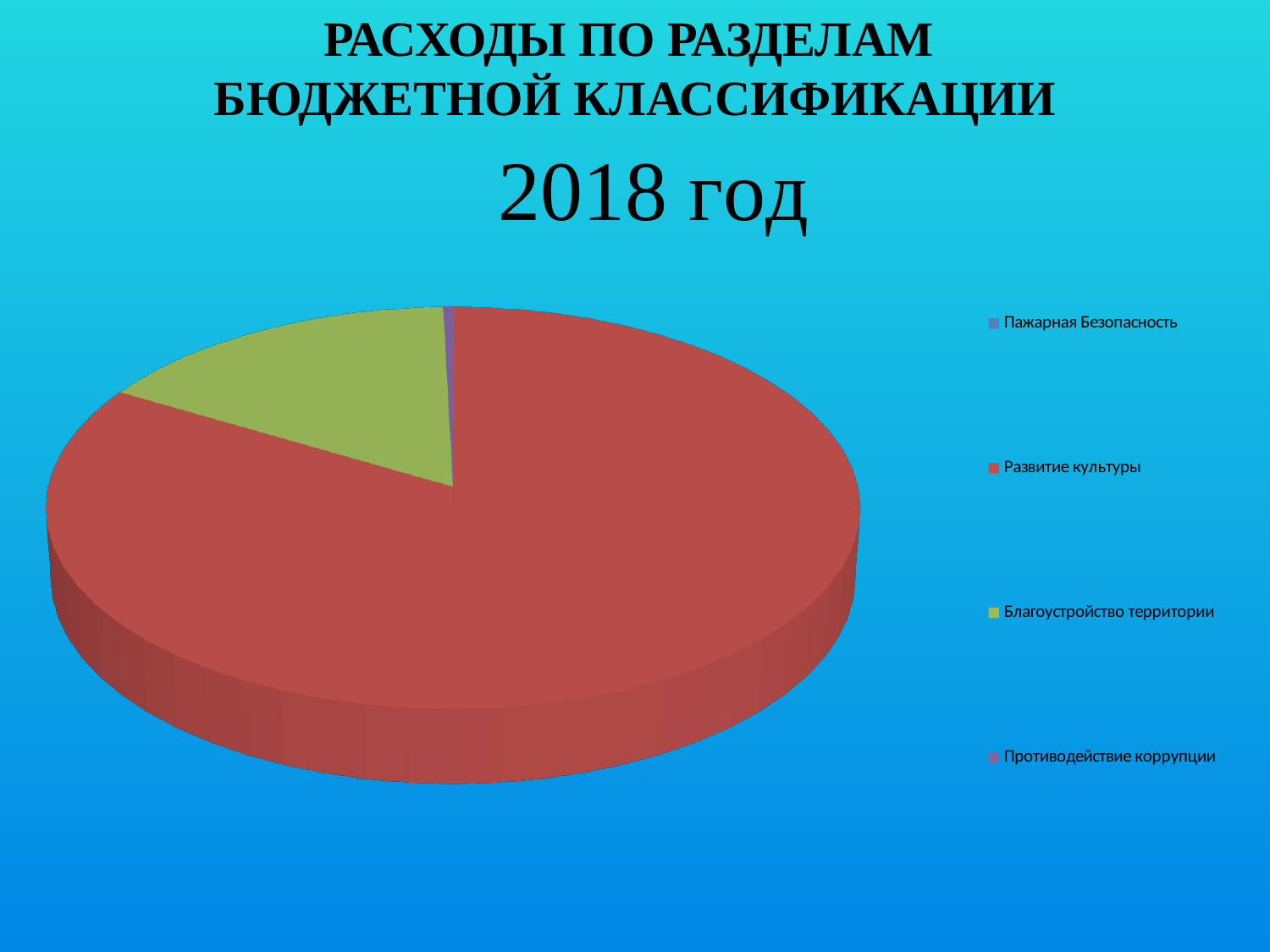
What kind of chart is shown on the slide? pie chart Which slice is larger: Благоустройство территории or Пажарная Безопасность? Благоустройство территории What colour is the slice for Благоустройство территории? green Which year does the chart on the slide refer to? 2018 год Which category has the second-largest slice of the pie chart? Благоустройство территории How many categories does the legend of the pie chart list? 4 Which slice is larger: Развитие культуры or Благоустройство территории? Развитие культуры Which category has the largest slice of the pie chart? Развитие культуры